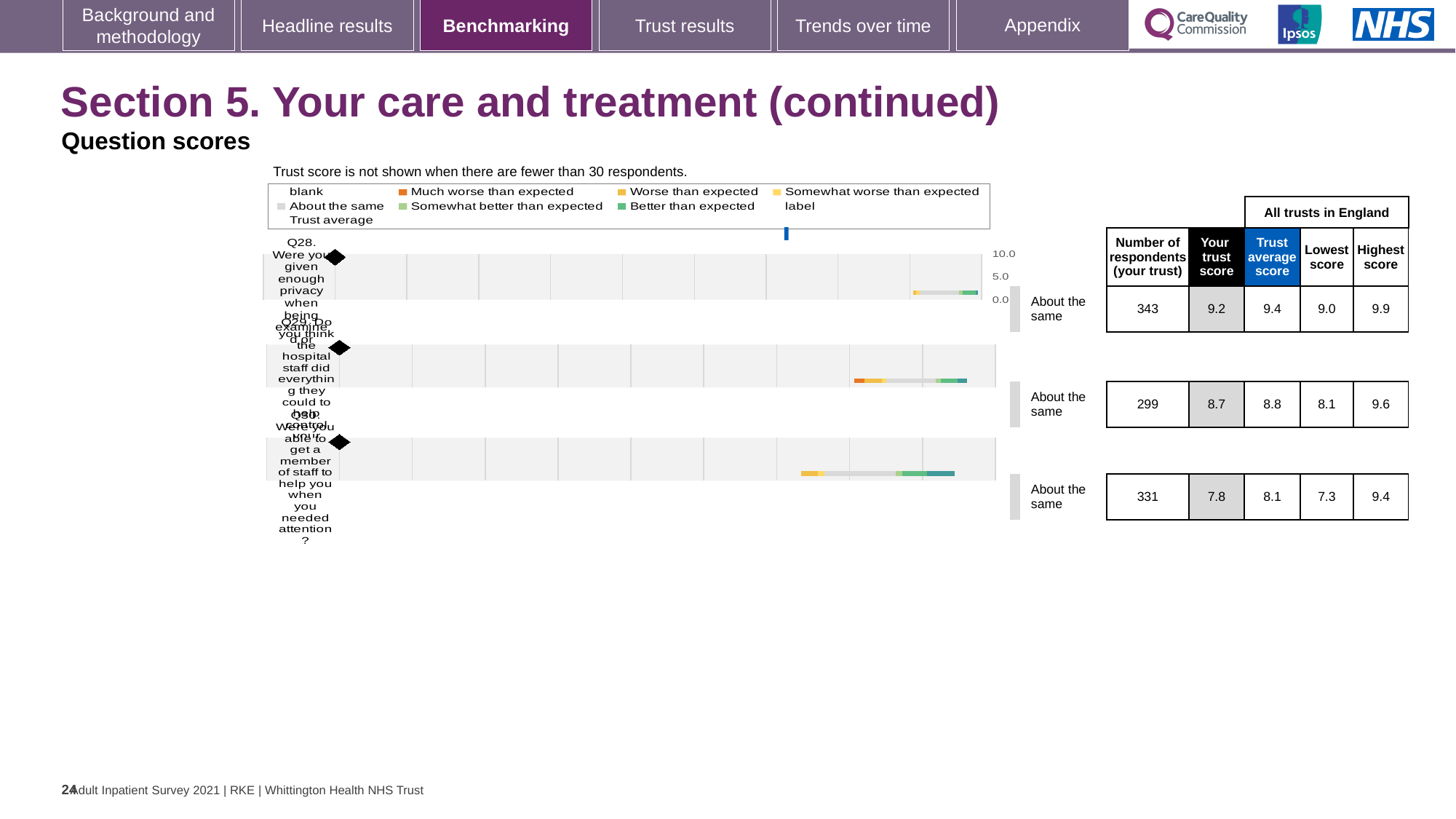
Which of the three questions shown (Q28, Q29, Q30) has the lowest trust score? Q30 How many question charts are shown on the slide? 3 What is the trust score for Q28 (Were you given enough privacy when being examined or treated)? 9.2 What is the trust average score for Q30 (Were you able to get a member of staff to help you when you needed attention)? 8.1 Is the trust score for Q30 greater or less than 5.0 on the chart axis? greater How many respondents from your trust answered Q29? 299 For Q29, which is larger: your trust score or the trust average score? Trust average score What is the highest score across all trusts in England for Q29? 9.6 What benchmark category is shown for Q30? About the same What kind of chart is used to show the question scores? Bar chart What is the difference between the highest score and the lowest score for Q28? 0.9 Which of the three questions shown (Q28, Q29, Q30) has the highest trust score? Q28